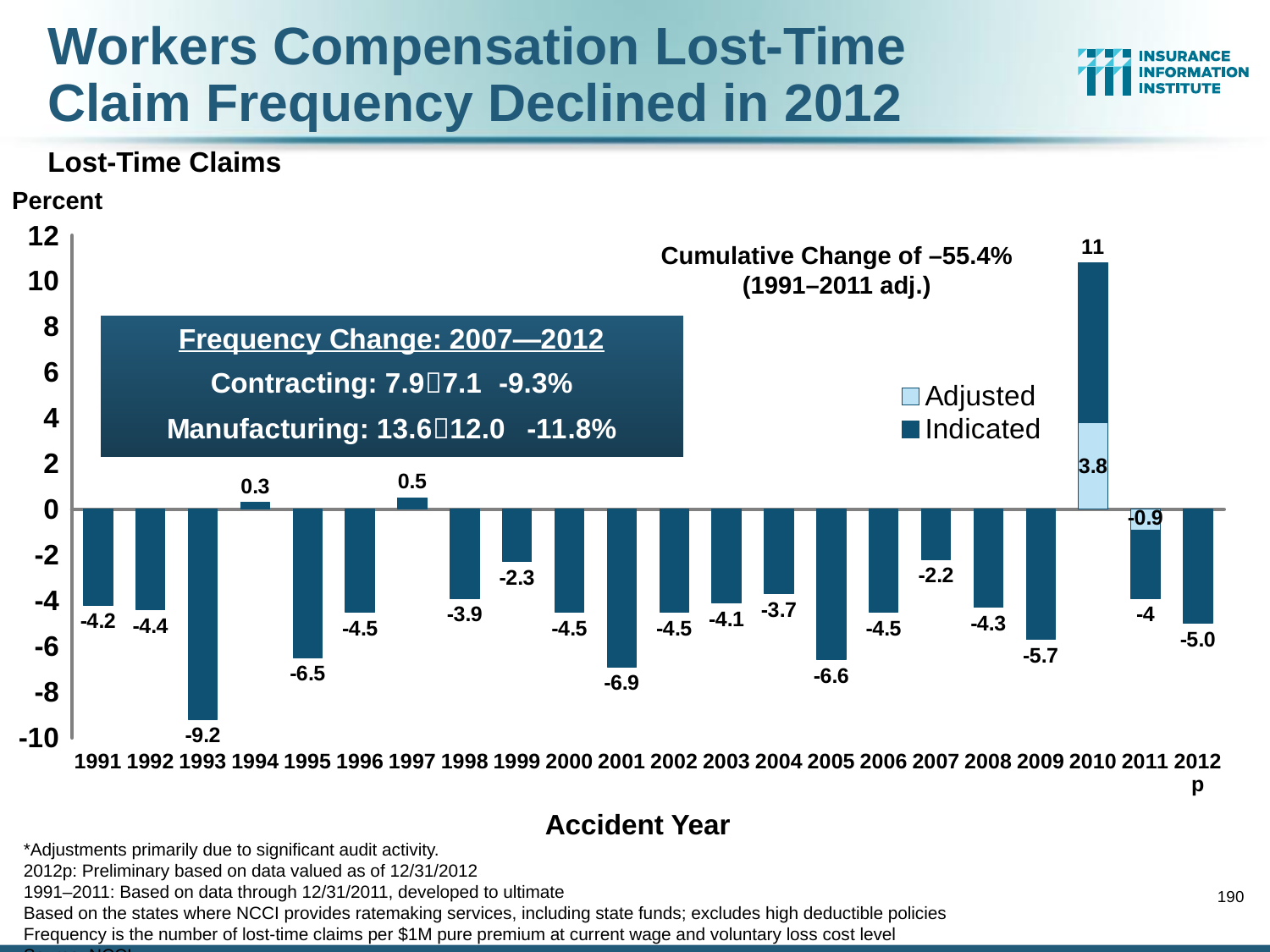
What is the Adjusted value for 2010? 3.8 Which is larger, the value for 1998 or the value for 1999? 1999 What is the Adjusted value for 2011? -0.9 Which accident year has the lowest value? 1993 What is the value for 2012p? -5.0 What is the difference between the values for 2001 and 2005? 0.3 What is the value for 1993? -9.2 How many accident years are shown on the x axis? 22 How many series does the legend list? 2 What is the Indicated value for 2010? 11 What kind of chart is shown on the slide? Bar chart Which accident year has the highest value? 2010